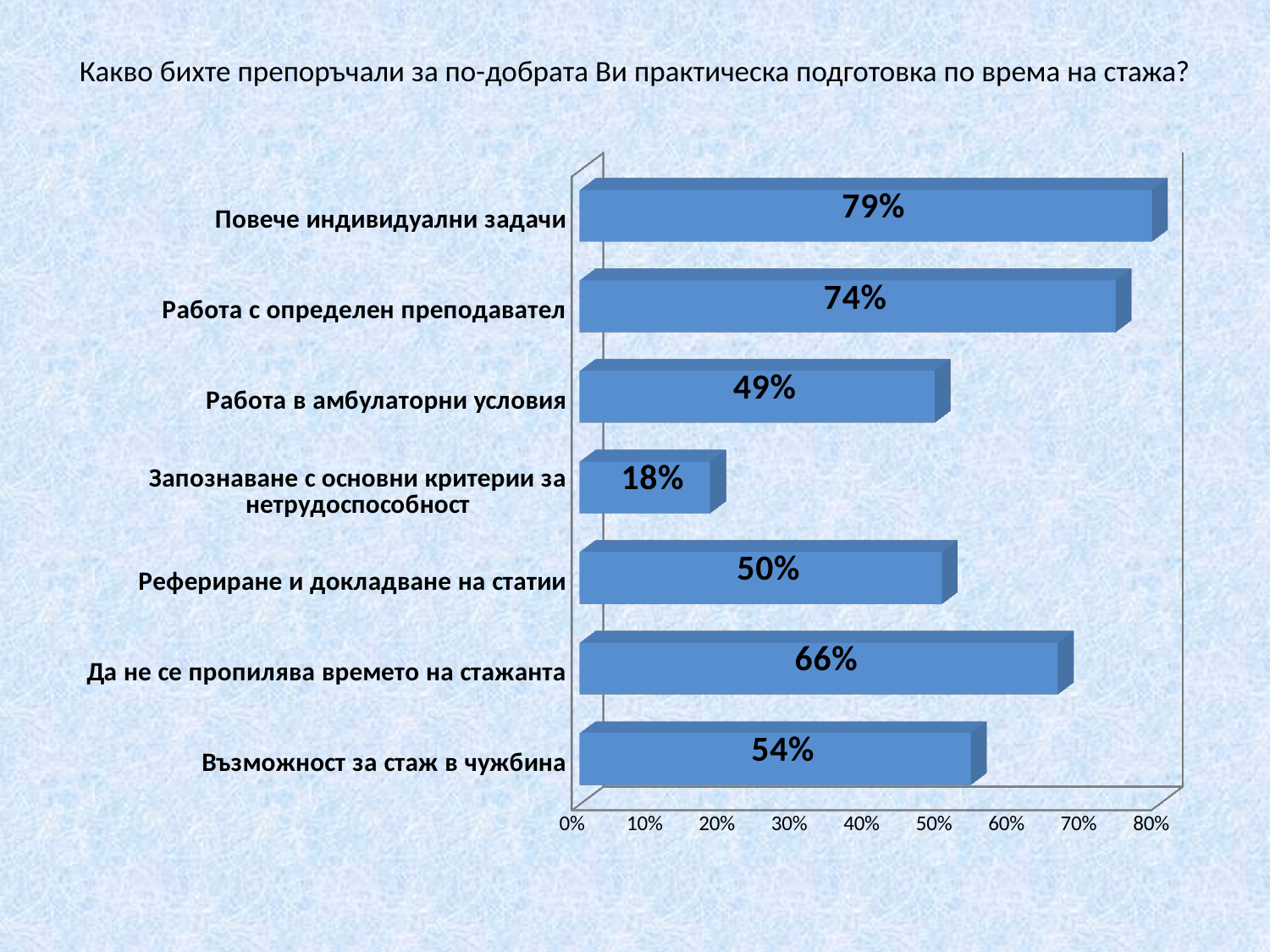
What kind of chart is shown on the slide? bar chart What is the difference between the values for "Повече индивидуални задачи" and "Работа с определен преподавател"? 5% Which is larger: the value for "Работа в амбулаторни условия" or for "Рефериране и докладване на статии"? Рефериране и докладване на статии How many categories are shown in the chart? 7 What is the title of the slide above the chart? Какво бихте препоръчали за по-добрата Ви практическа подготовка по време на стажа? Which category has the lowest value? Запознаване с основни критерии за нетрудоспособност What value is shown for "Запознаване с основни критерии за нетрудоспособност"? 18% Which category has the highest value? Повече индивидуални задачи Is the value for "Да не се пропилява времето на стажанта" greater or less than 60%? greater What value is shown for "Да не се пропилява времето на стажанта"? 66% What value is shown for "Повече индивидуални задачи"? 79% What value is shown for "Възможност за стаж в чужбина"? 54%